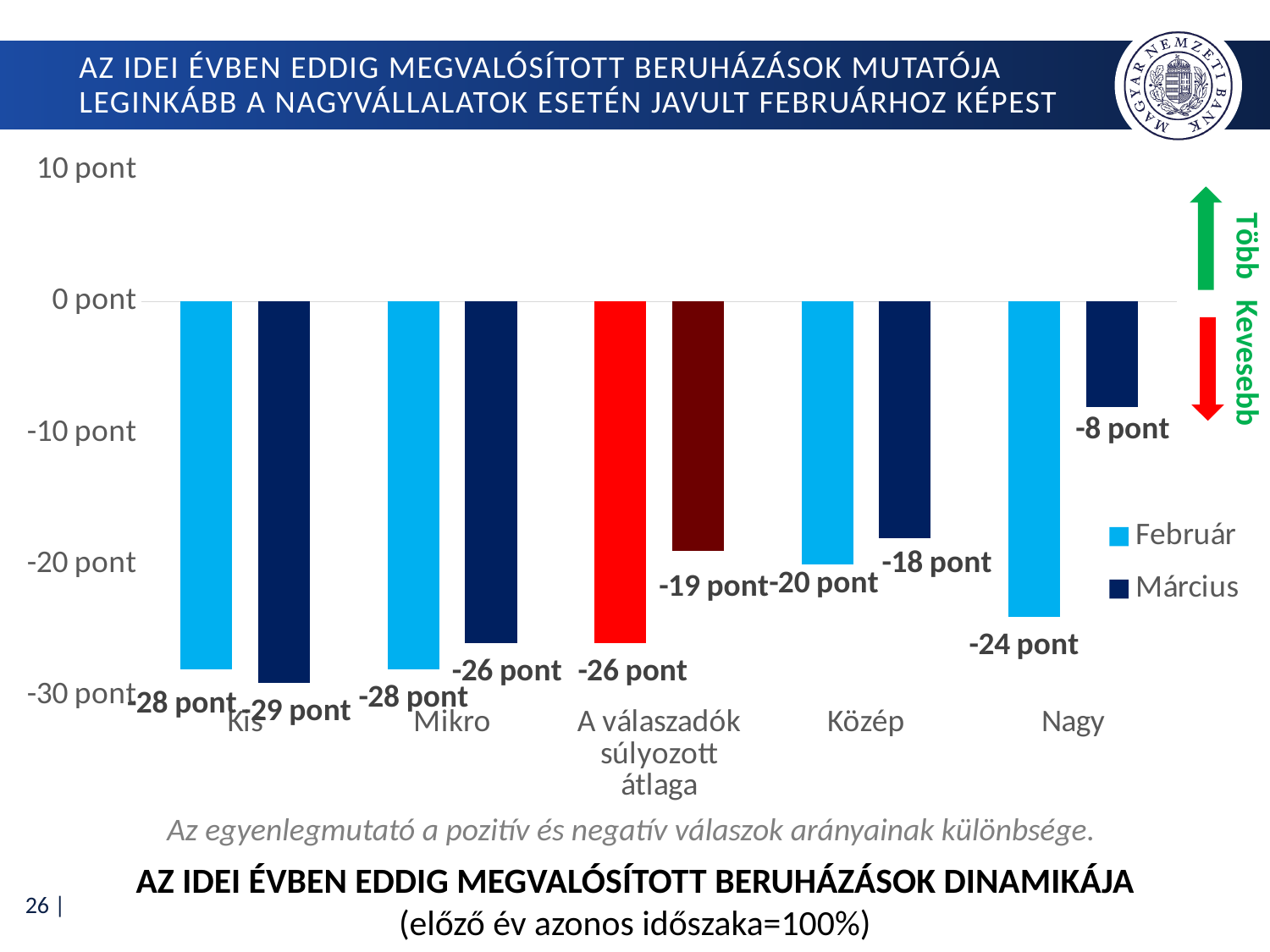
Which is higher for Mikro, the Február value or the Március value? Március How many series does the legend list? 2 What is the Február value for A válaszadók súlyozott átlaga? -26 pont What is the Március value for Nagy? -8 pont What is the difference between the Február and Március values for Nagy? 16 pont Which colour represents the Február series in the legend? Light blue Which category has the lowest Március value? Kis What is the Március value for Kis? -29 pont What kind of chart is shown on the slide? Bar chart What is the Február value for Közép? -20 pont How many categories are shown on the x axis? 5 Which category has the highest (least negative) Március value? Nagy